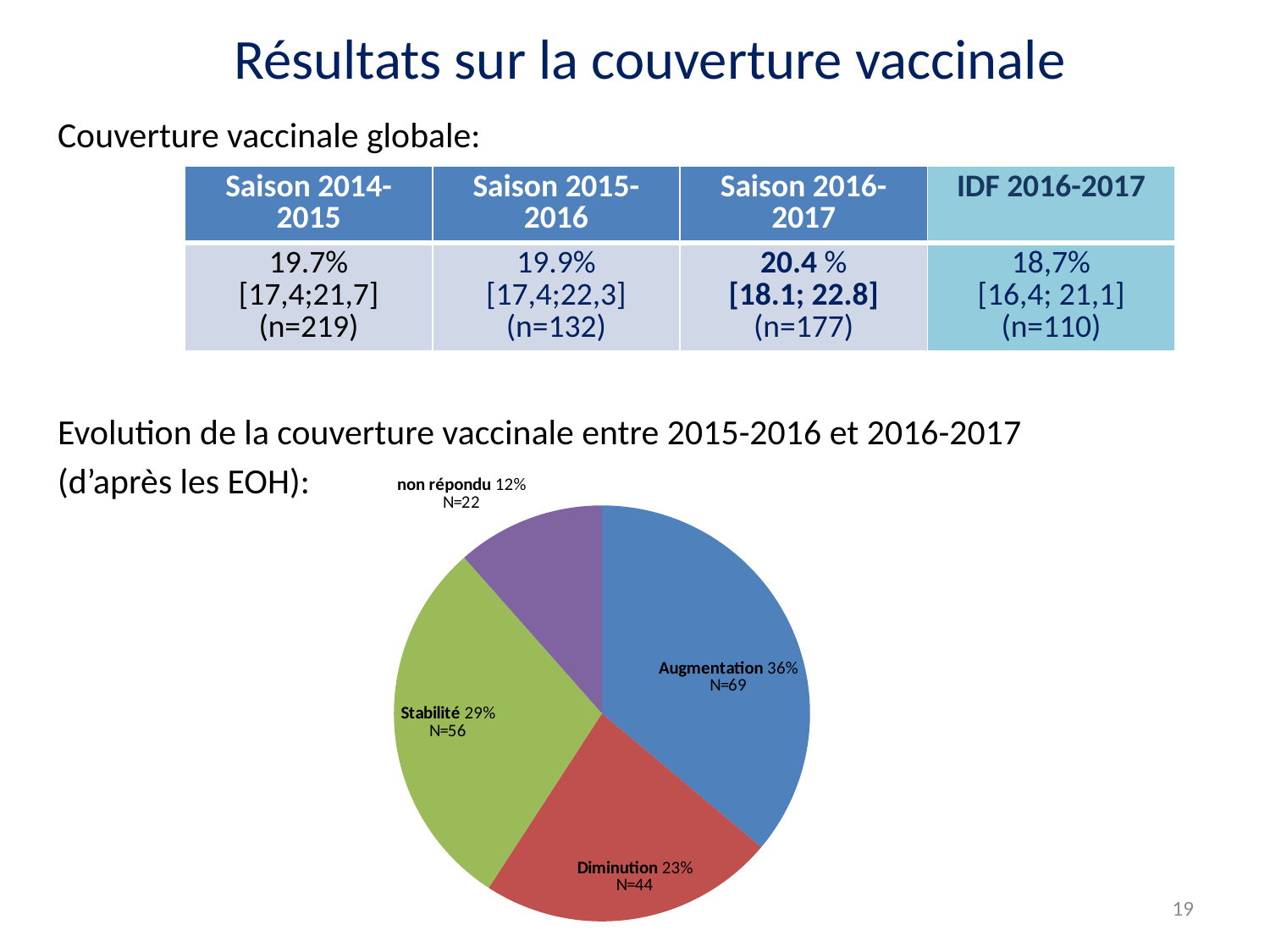
What colour is the Augmentation slice in the pie chart? blue What percentage share does the Stabilité slice have in the pie chart? 29% In the pie chart, what is the difference in percentage points between Stabilité and non répondu? 17 What is the N value for the Diminution slice in the pie chart? N=44 Which slice of the pie chart is the largest? Augmentation What percentage share does the Augmentation slice have in the pie chart? 36% How many slices does the pie chart have? 4 Which slice of the pie chart is the smallest? non répondu In the pie chart, which is larger: the Stabilité slice or the Diminution slice? Stabilité What kind of chart is shown on the slide? pie chart What is the N value for the non répondu slice in the pie chart? N=22 In the pie chart, what is the difference in N between Augmentation and Diminution? 25